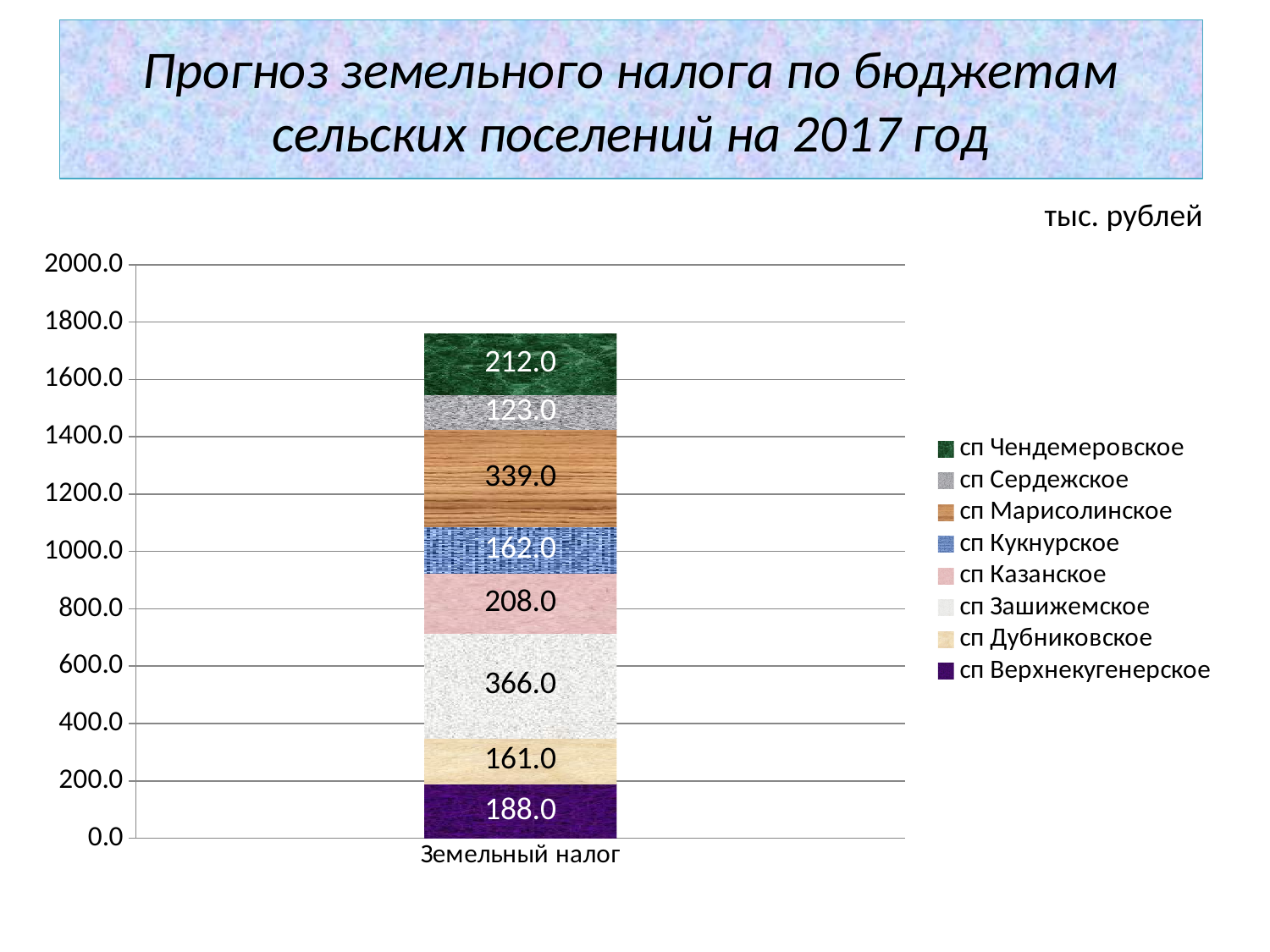
How many series does the legend list? 8 Which settlement has the highest land tax forecast? сп Зашижемское What is the total of the stacked bar for Земельный налог? 1759.0 What is the value for сп Марисолинское? 339.0 What is the value for сп Сердежское? 123.0 What is the value for сп Зашижемское? 366.0 What type of chart is shown on the slide? Stacked bar chart What is the difference between the values for сп Зашижемское and сп Марисолинское? 27.0 Which settlement has the lowest land tax forecast? сп Сердежское Which is larger, the value for сп Казанское or сп Чендемеровское? сп Чендемеровское What is the value for сп Верхнекугенерское? 188.0 What unit is stated above the chart? тыс. рублей